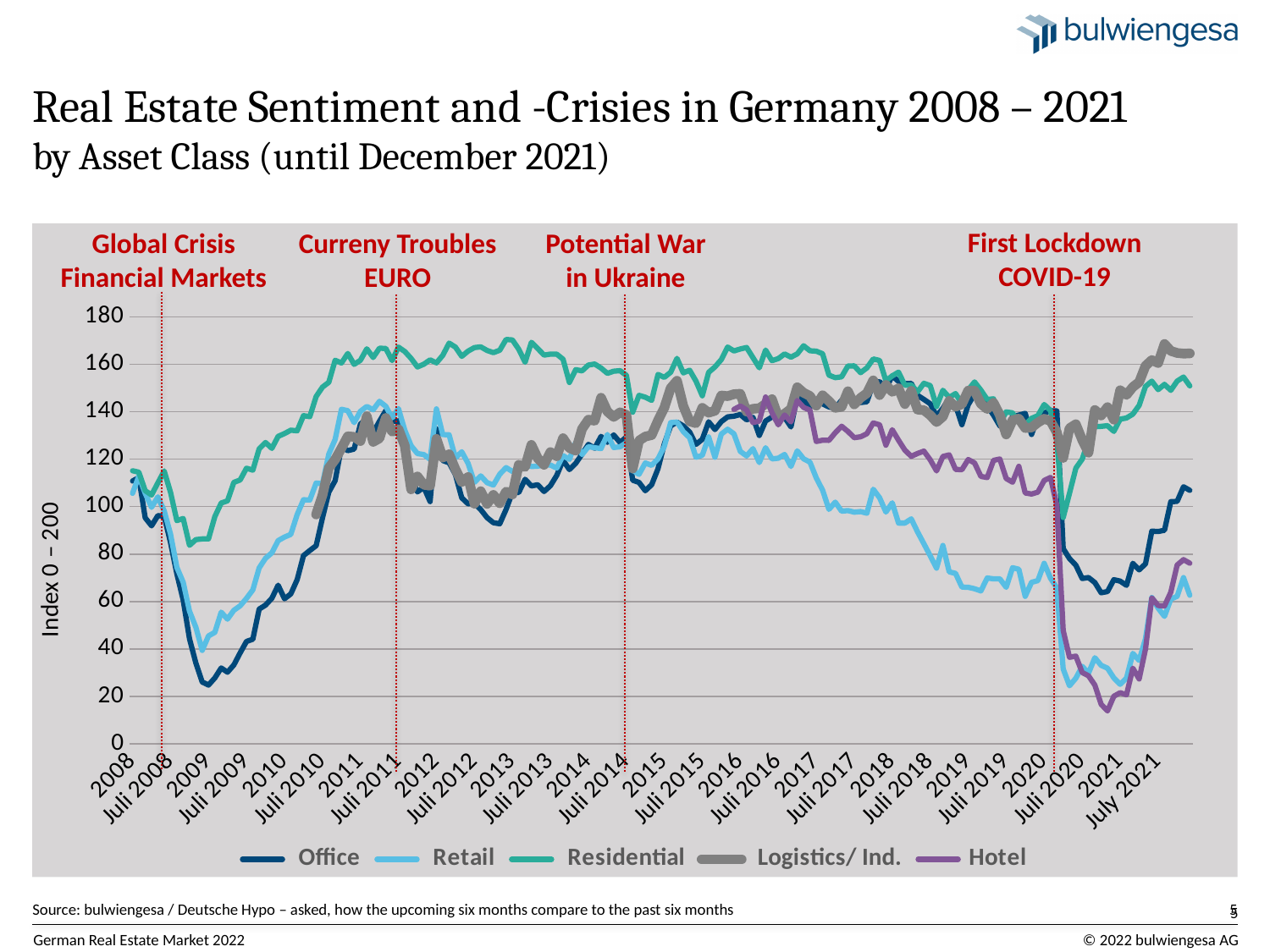
What is the label of the vertical axis? Index 0 – 200 Which series has the lowest value at 2021? Hotel At 2009, which is higher, Residential or Office? Residential What kind of chart is shown on the slide? line chart Which asset classes are listed in the legend? Office, Retail, Residential, Logistics/ Ind., Hotel Which series has the highest value at 2013? Residential Is the value for Residential at 2013 greater or less than 160? greater Is the value for Office at 2009 greater or less than 40? less Does the Retail series rise or fall between 2017 and 2019? fall How many series does the legend list? 5